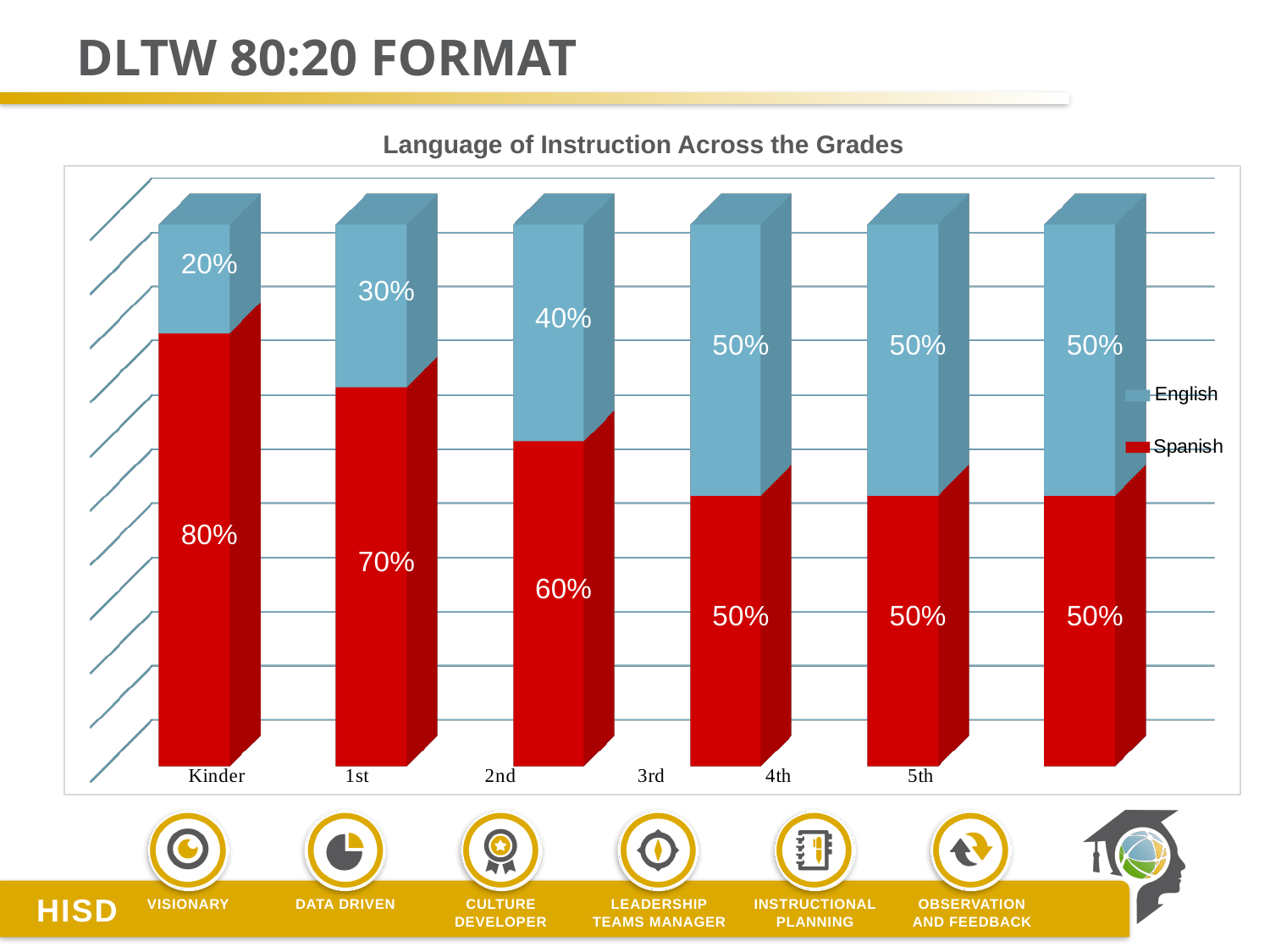
What is the title of the chart? Language of Instruction Across the Grades Which is larger for 1st grade, the Spanish value or the English value? Spanish What kind of chart is shown on the slide? Stacked bar chart How many grade categories are shown on the x axis? 6 What is the Spanish value for 2nd grade? 60% Which grade has the lowest English value? Kinder Does the Spanish share rise or fall from Kinder to 3rd grade? Fall What is the difference between the Spanish value for Kinder and the Spanish value for 2nd grade? 20% What is the Spanish value for Kinder? 80% How many series does the chart legend list? 2 What is the English value for 1st grade? 30% Which grade has the highest Spanish value? Kinder